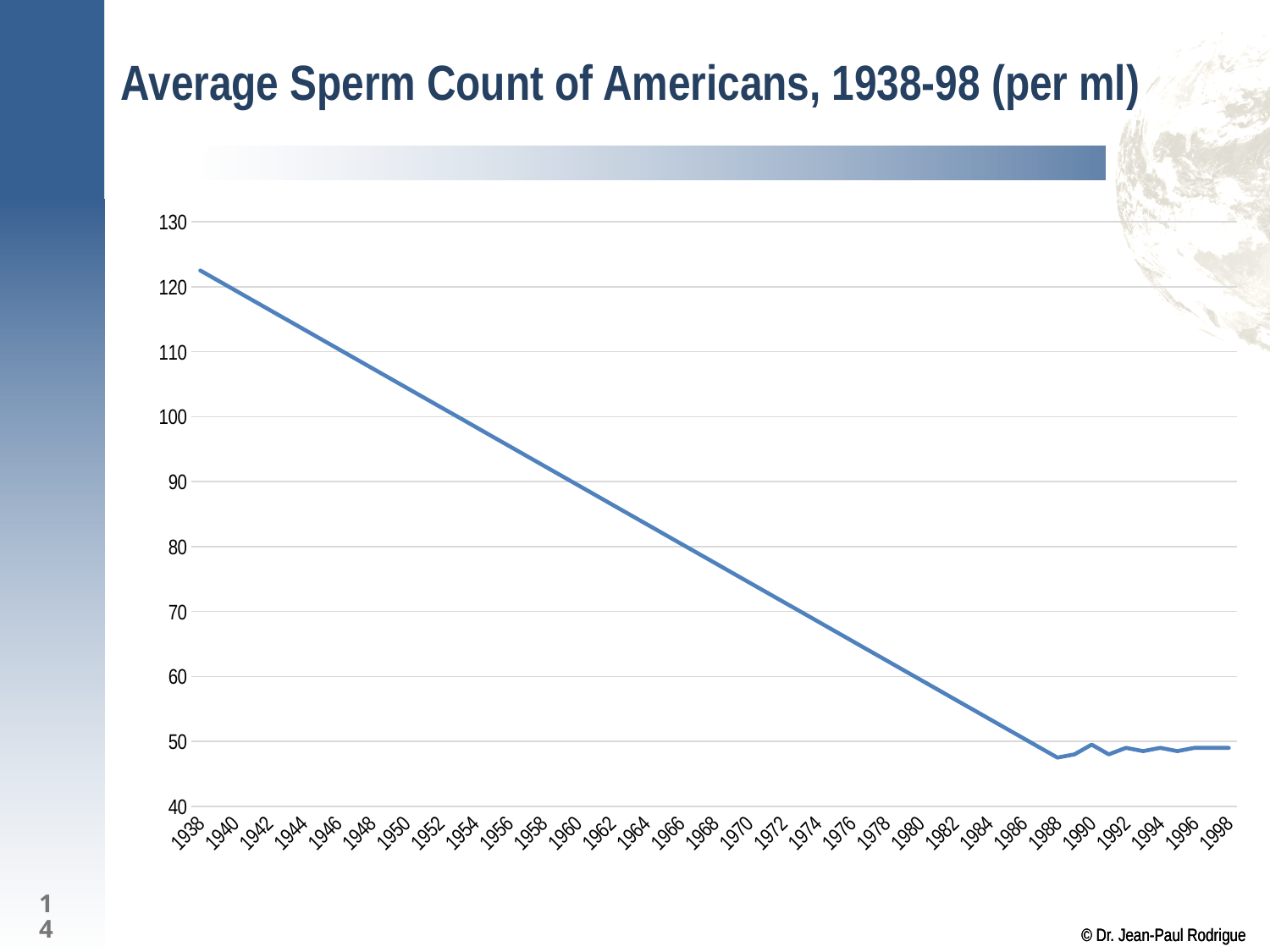
Is the value for 1956 greater or less than 100? less What is the highest value shown on the y axis? 130 Which year has the highest average sperm count on the chart? 1938 Is the value for 1938 greater or less than 110? greater Is the value for 1970 greater or less than 80? less How many year labels are shown on the x axis? 31 Which is larger, the value for 1940 or the value for 1990? 1940 Do the values generally rise or fall from 1938 to 1986? fall What is the title of the chart? Average Sperm Count of Americans, 1938-98 (per ml) What kind of chart is shown on the slide? line chart